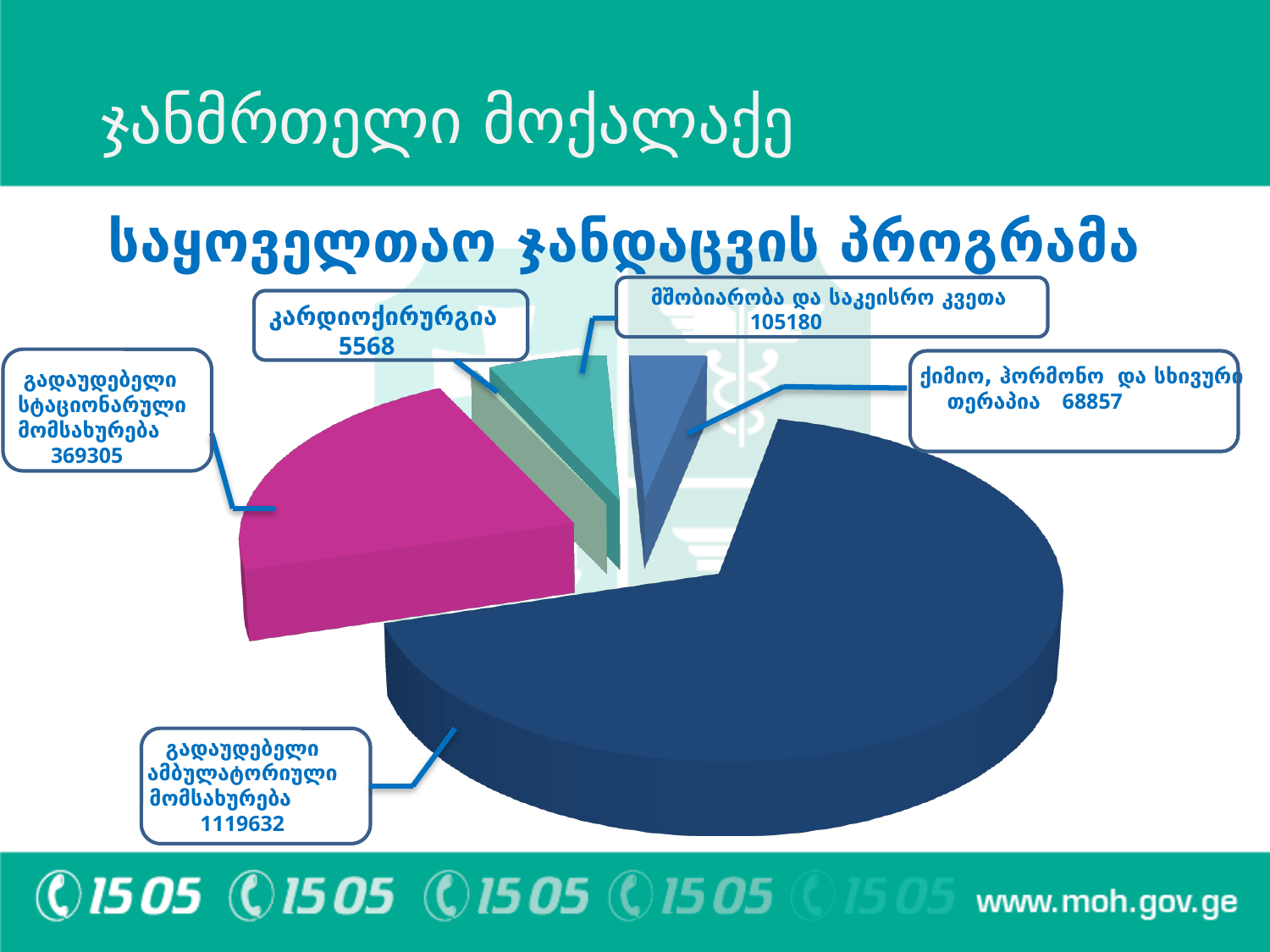
Which category has the smallest slice of the pie? კარდიოქირურგია What is the value for გადაუდებელი ამბულატორიული მომსახურება? 1119632 What kind of chart is shown on the slide? pie chart Which is larger: the value for მშობიარობა და საკეისრო კვეთა or the value for ქიმიო, ჰორმონო და სხივური თერაპია? მშობიარობა და საკეისრო კვეთა What is the value for გადაუდებელი სტაციონარული მომსახურება? 369305 What is the value for კარდიოქირურგია? 5568 Which category has the largest slice of the pie? გადაუდებელი ამბულატორიული მომსახურება What is the difference between the values for გადაუდებელი ამბულატორიული მომსახურება and გადაუდებელი სტაციონარული მომსახურება? 750327 What is the value for მშობიარობა და საკეისრო კვეთა? 105180 What is the title of the chart? საყოველთაო ჯანდაცვის პროგრამა What is the value for ქიმიო, ჰორმონო და სხივური თერაპია? 68857 How many slices does the pie chart have? 5